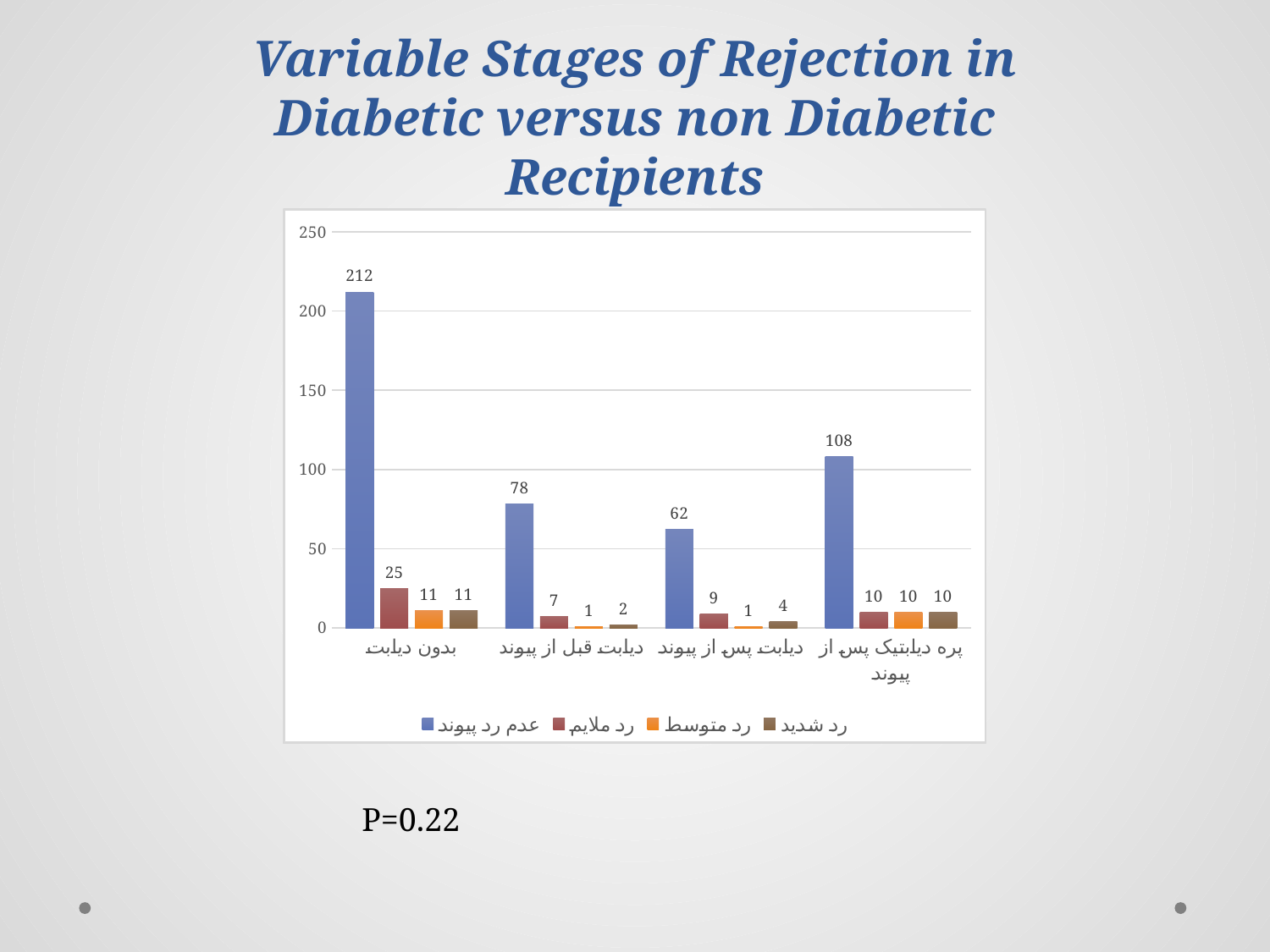
What is the value of the عدم رد پیوند series for the پره دیابتیک پس از پیوند category? 108 Which is larger: the عدم رد پیوند value for دیابت قبل از پیوند or for دیابت پس از پیوند? دیابت قبل از پیوند What is the difference between the عدم رد پیوند values for بدون دیابت and پره دیابتیک پس از پیوند? 104 Which category has the lowest value for the عدم رد پیوند series? دیابت پس از پیوند How many categories are shown on the x axis of the chart? 4 What kind of chart is shown on the slide? Bar chart Which category has the highest value for the عدم رد پیوند series? بدون دیابت What is the value of the عدم رد پیوند series for the بدون دیابت category? 212 What is the value of the رد شدید series for the دیابت پس از پیوند category? 4 What is the value of the رد ملایم series for the بدون دیابت category? 25 What P value is printed below the chart? P=0.22 How many series does the legend list? 4